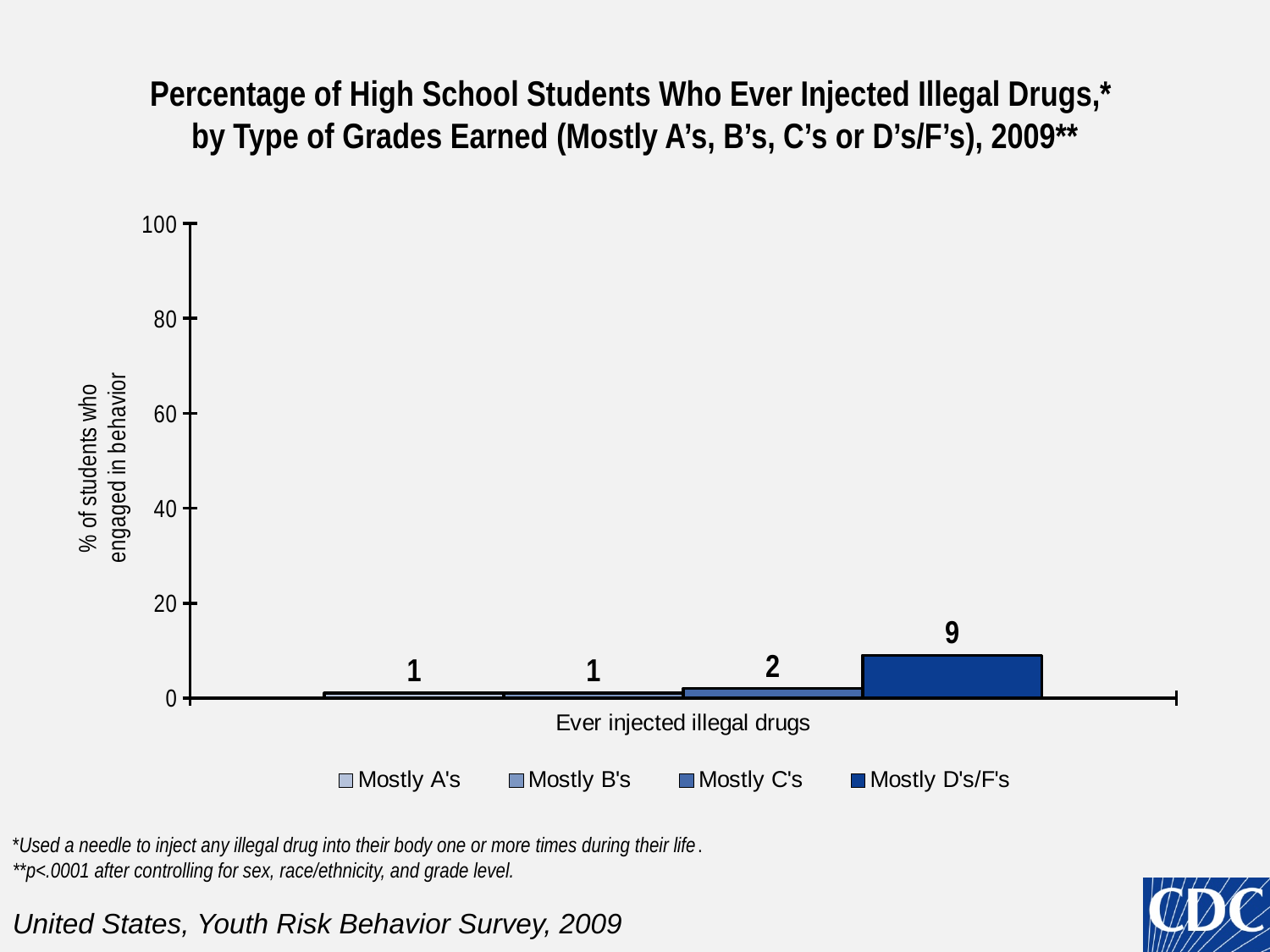
Which is larger, the value for Mostly C's or the value for Mostly D's/F's? Mostly D's/F's Is the value for Mostly D's/F's greater or less than 20? less Which grade group has the highest percentage of students who ever injected illegal drugs? Mostly D's/F's What is the label on the y axis? % of students who engaged in behavior What is the difference between the values for Mostly D's/F's and Mostly C's? 7 What is the value for Mostly D's/F's? 9 What is the value for Mostly C's? 2 How many series does the legend list? 4 What kind of chart is shown on the slide? bar chart What is the category label shown on the x axis? Ever injected illegal drugs What is the difference between the values for Mostly D's/F's and Mostly B's? 8 What is the value for Mostly A's? 1